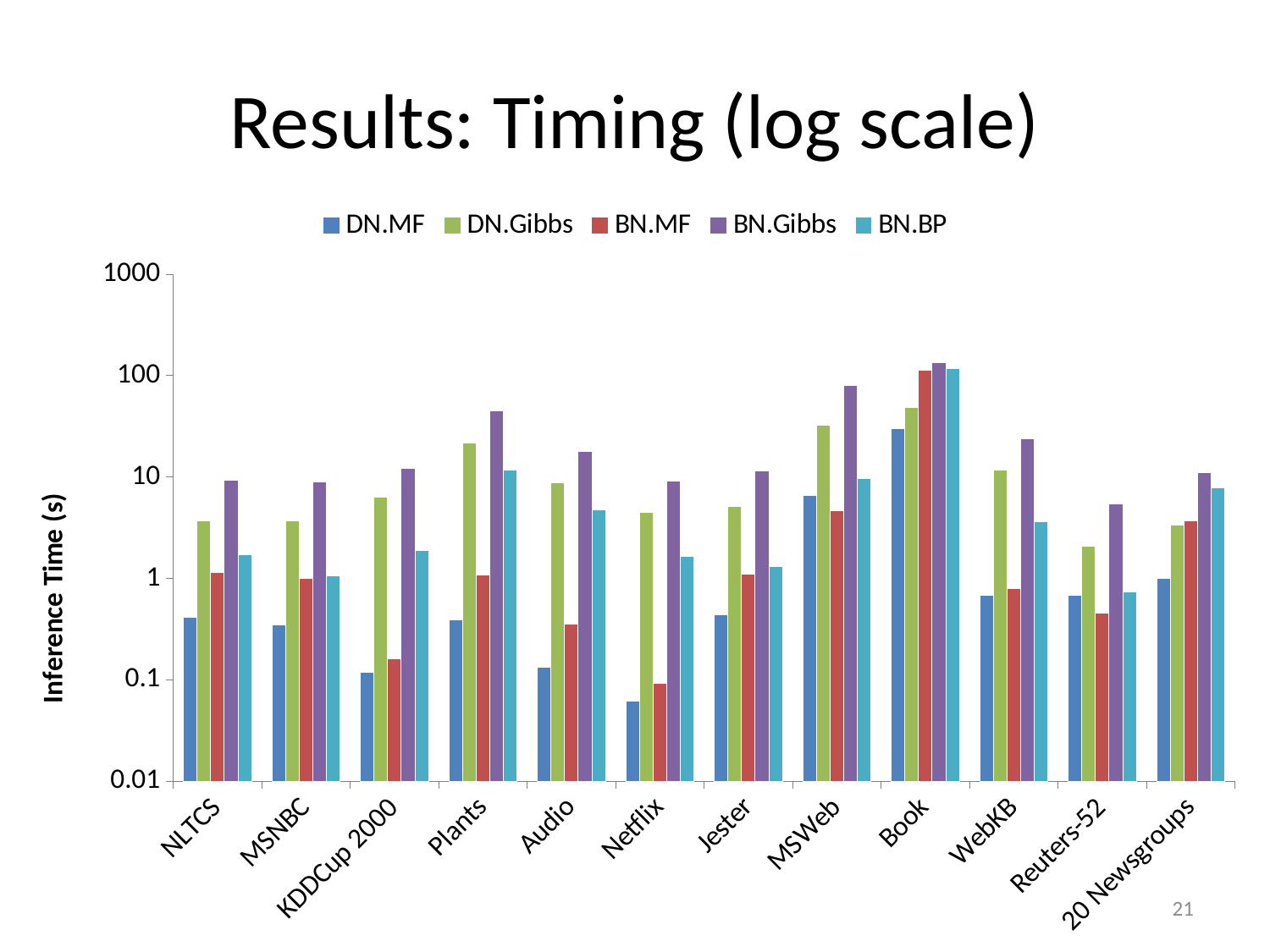
Is the DN.MF value for Netflix greater or less than 0.1? less Is the DN.MF value for NLTCS greater or less than 1? less How many series does the legend list? 5 How many datasets (categories) are shown along the x axis? 12 Which dataset has the highest BN.Gibbs inference time? Book What is the label of the y axis? Inference Time (s) For MSWeb, which is larger: BN.MF or BN.BP? BN.BP What kind of chart is shown on the slide? bar chart For NLTCS, which is larger: DN.Gibbs or BN.Gibbs? BN.Gibbs Which dataset has the lowest DN.MF inference time? Netflix Is the BN.Gibbs value for Book greater or less than 100? greater